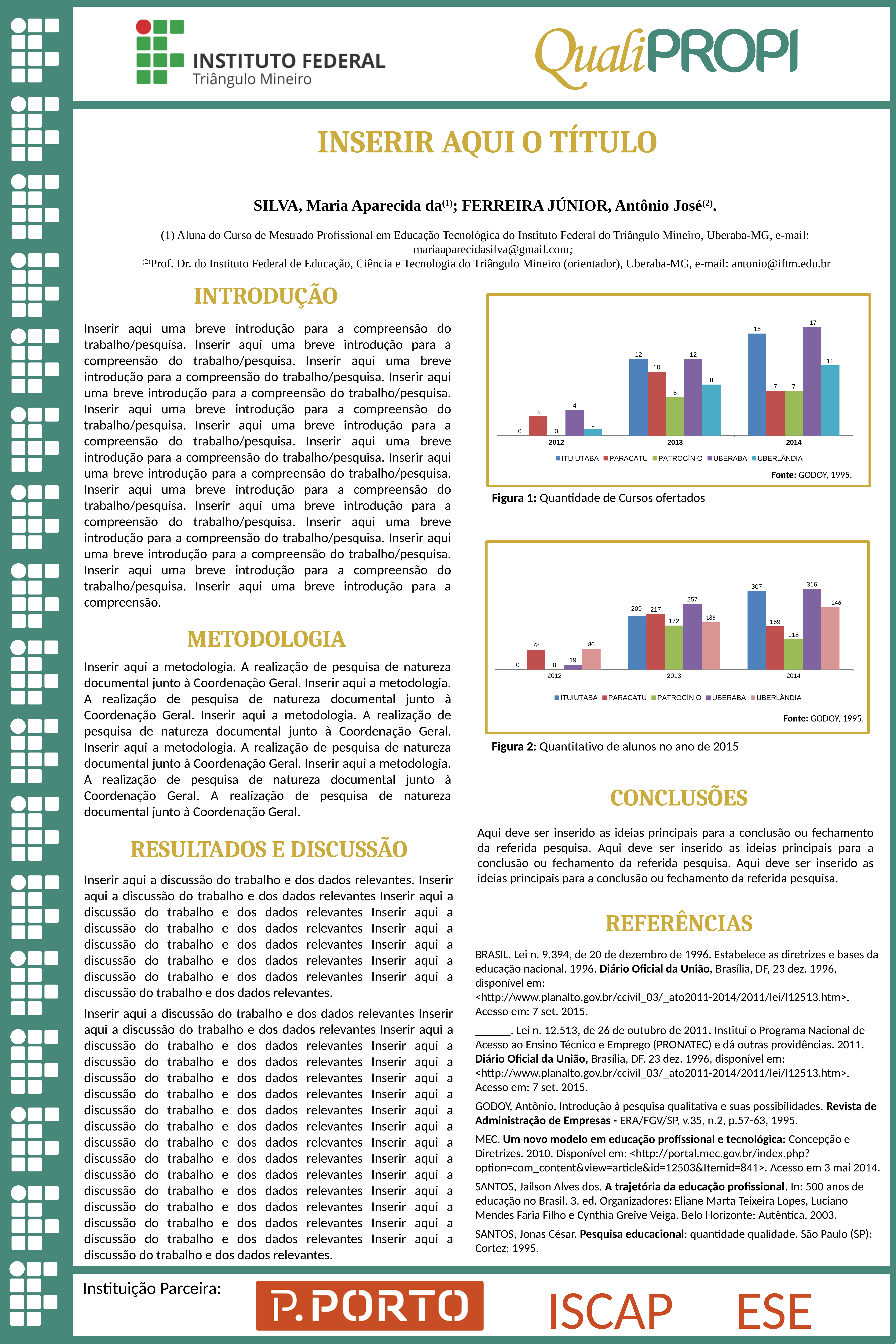
In Figura 1 (Quantidade de Cursos ofertados), what is the value for PATROCÍNIO in 2013? 6 In Figura 1 (Quantidade de Cursos ofertados), does the value for ITUIUTABA rise or fall from 2012 to 2014? rise In Figura 2 (Quantitativo de alunos no ano de 2015), which is larger in 2013: ITUIUTABA or PARACATU? PARACATU In Figura 1 (Quantidade de Cursos ofertados), which series has the highest value in 2014? UBERABA What kind of chart is Figura 2 (Quantitativo de alunos no ano de 2015)? bar chart In Figura 1 (Quantidade de Cursos ofertados), what is the value for UBERABA in 2014? 17 In Figura 1 (Quantidade de Cursos ofertados), how many series does the legend list? 5 In Figura 2 (Quantitativo de alunos no ano de 2015), what is the value for UBERLÂNDIA in 2012? 80 In Figura 2 (Quantitativo de alunos no ano de 2015), what is the difference between UBERABA and ITUIUTABA in 2014? 9 In Figura 2 (Quantitativo de alunos no ano de 2015), what is the value for UBERABA in 2013? 257 In Figura 2 (Quantitativo de alunos no ano de 2015), which series has the lowest value in 2014? PATROCÍNIO In Figura 1 (Quantidade de Cursos ofertados), what is the difference between ITUIUTABA and PARACATU in 2014? 9